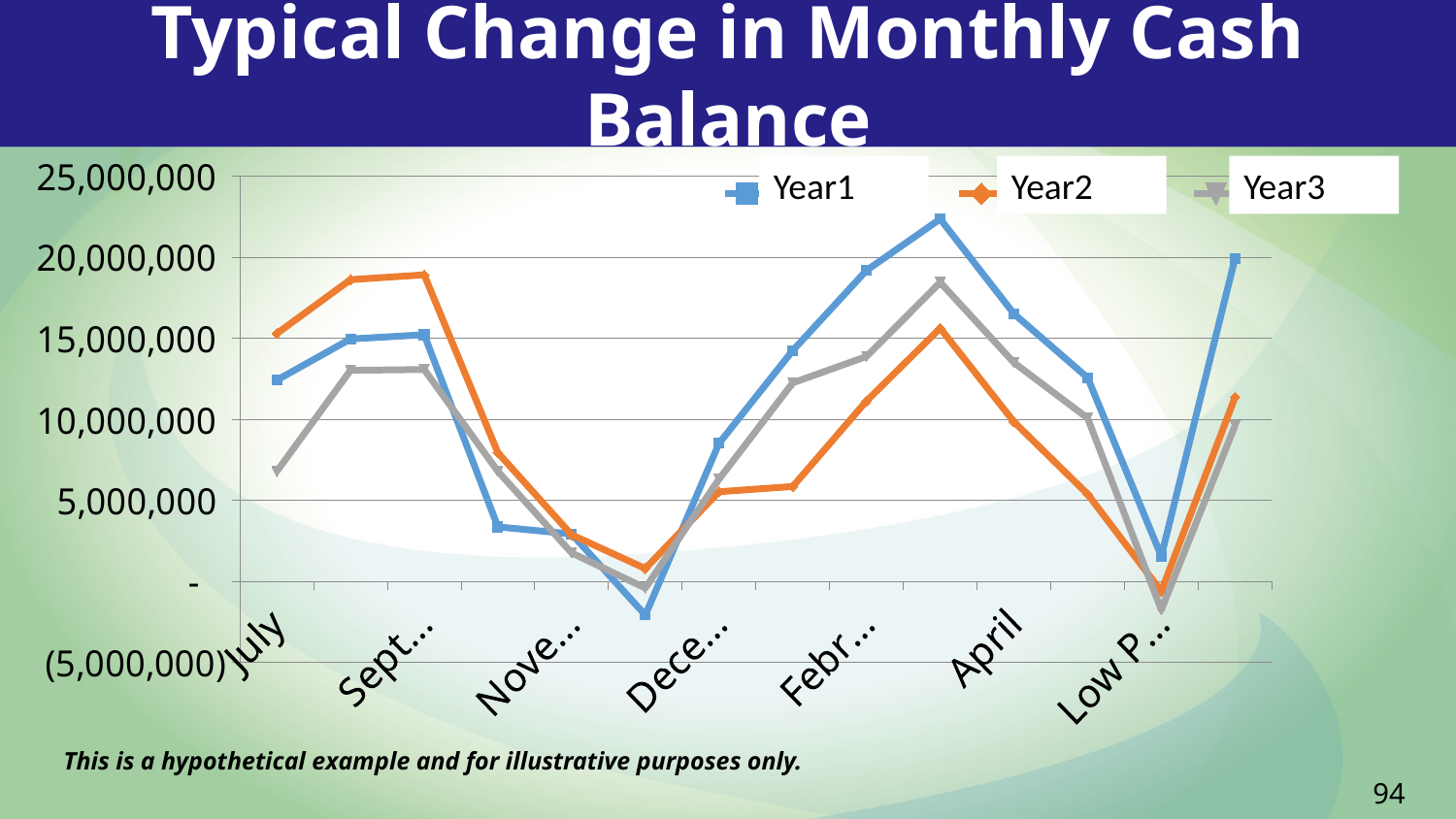
Is the Year1 value for April greater or less than 20,000,000? less In April, which series has the highest value? Year1 How many series does the legend list? 3 Is the Year3 value for July greater or less than 10,000,000? less Which colour is used for the Year2 line? orange Is the Year3 value for April greater or less than 15,000,000? less In July, which series has the lowest value? Year3 What is the title of the chart? Typical Change in Monthly Cash Balance In July, which is larger: the Year2 value or the Year3 value? Year2 What kind of chart is shown on the slide? line chart